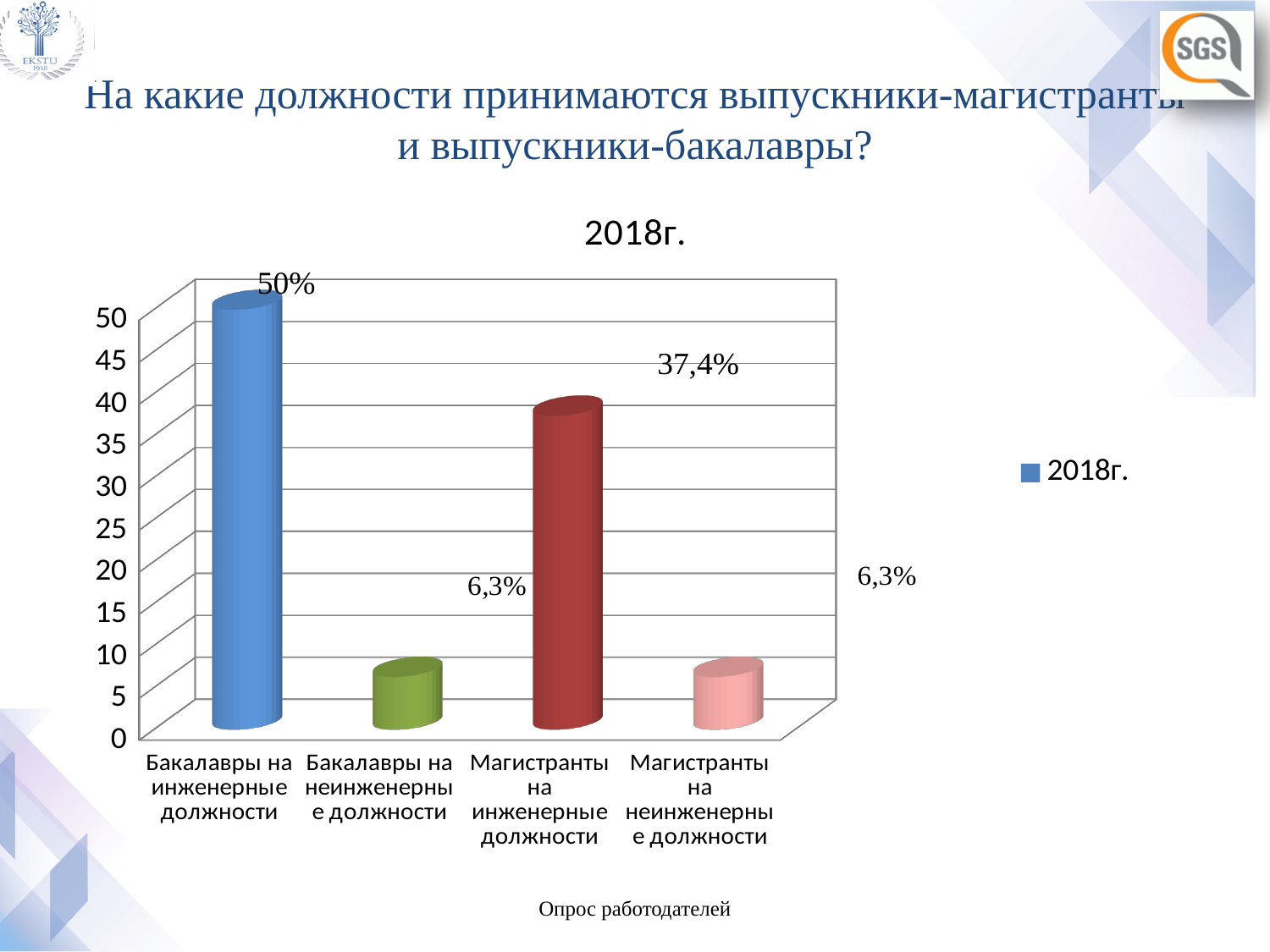
Is the value for Магистранты на инженерные должности greater or less than 30? greater What is the title of the chart? 2018г. How many series does the legend list? 1 What is the value for Бакалавры на инженерные должности? 50% What is the value for Бакалавры на неинженерные должности? 6,3% What is the value for Магистранты на инженерные должности? 37,4% Which category has the highest value? Бакалавры на инженерные должности How many categories are shown on the chart? 4 Which is larger: the value for Магистранты на инженерные должности or the value for Бакалавры на неинженерные должности? Магистранты на инженерные должности What is the value for Магистранты на неинженерные должности? 6,3% What is the difference between the values for Бакалавры на инженерные должности and Магистранты на инженерные должности? 12,6% What kind of chart is shown on the slide? bar chart